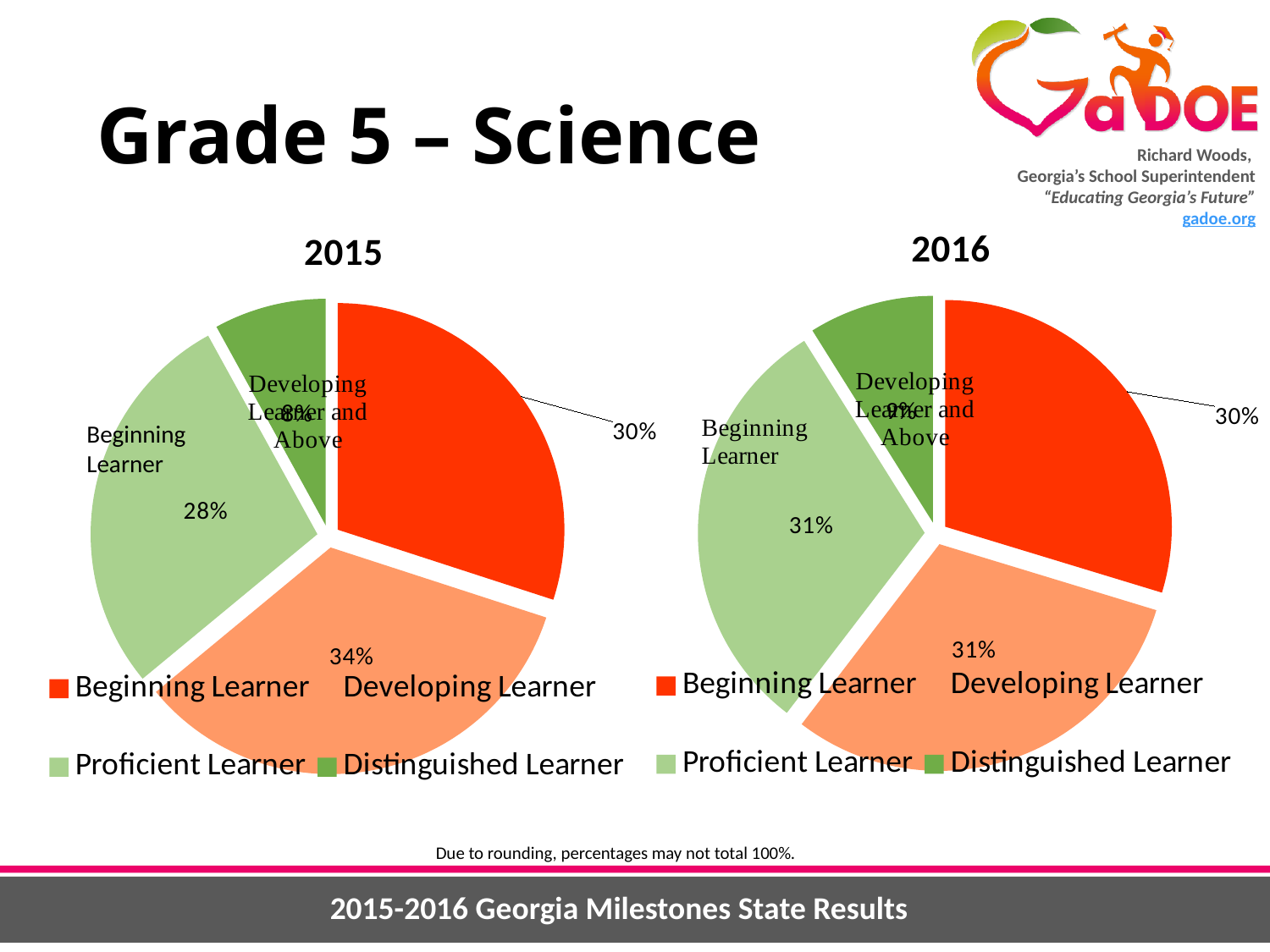
In the 2016 pie chart, what percentage is shown for Beginning Learner? 30% In the 2015 pie chart, what percentage is shown for Beginning Learner? 30% In the 2015 pie chart, what percentage is shown for Developing Learner? 34% In the 2015 pie chart, what percentage is shown for Proficient Learner? 28% In the 2016 pie chart, which category has the smallest share? Distinguished Learner What type of chart is used to show the 2015 results? Pie chart In the 2015 pie chart, what is the difference in percentage points between Developing Learner and Proficient Learner? 6 percentage points In the 2015 pie chart, which category has the smallest share? Distinguished Learner In the 2016 pie chart, what percentage is shown for Proficient Learner? 31% In the 2015 pie chart, which category has the largest share? Developing Learner How many categories does the legend of the 2016 chart list? 4 In the 2015 pie chart, which is larger: Beginning Learner or Proficient Learner? Beginning Learner